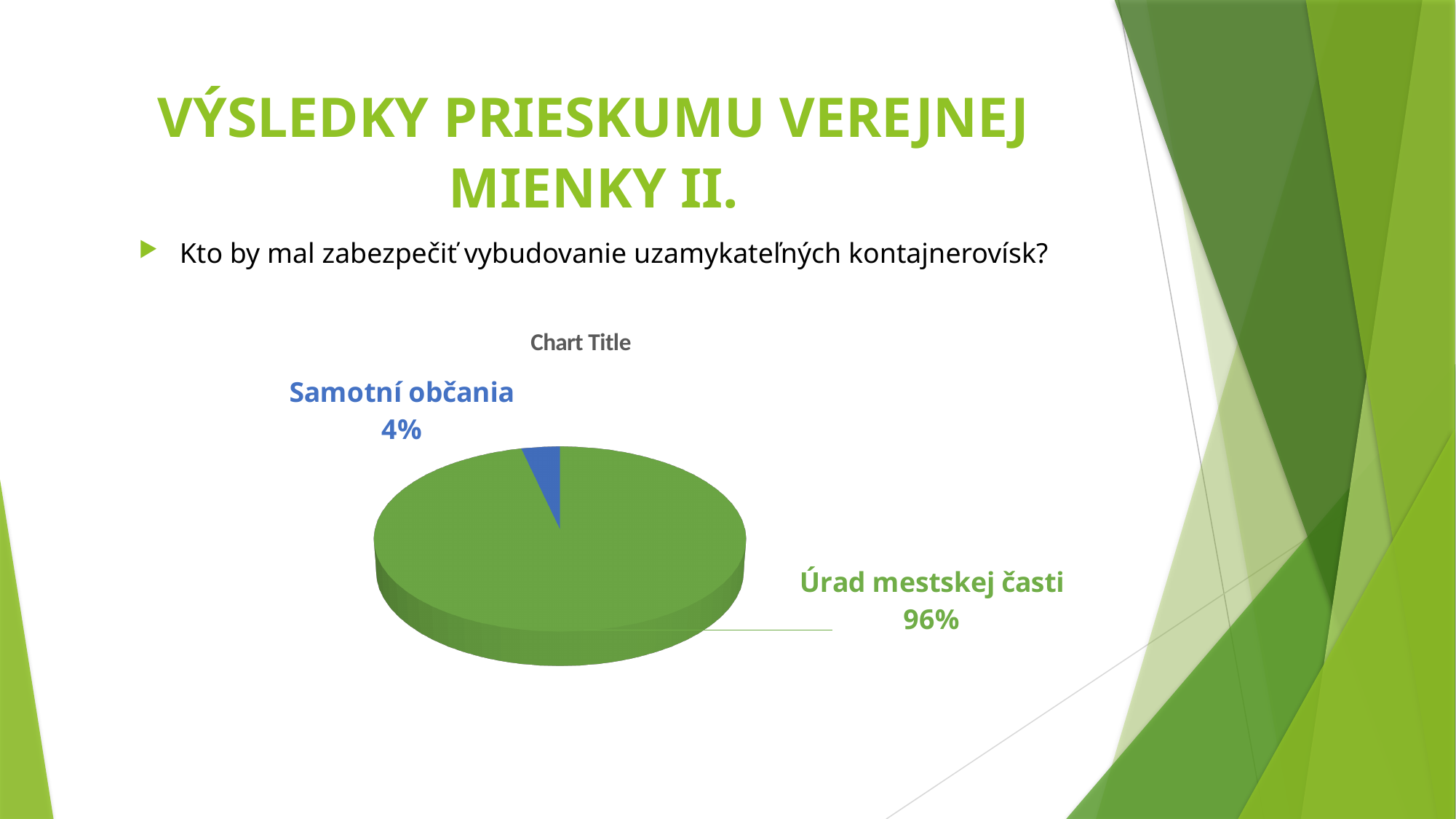
What share of the pie does "Úrad mestskej časti" have? 96% What colour is the slice for "Samotní občania"? blue What is the difference in percentage points between "Úrad mestskej časti" and "Samotní občania"? 92 How many slices does the pie chart have? 2 What is the title shown above the pie chart? Chart Title Which category has the largest slice of the pie? Úrad mestskej časti What share of the pie does "Samotní občania" have? 4% Which is larger, the share for "Samotní občania" or the share for "Úrad mestskej časti"? Úrad mestskej časti Which category has the smallest slice of the pie? Samotní občania What kind of chart is shown on the slide? pie chart